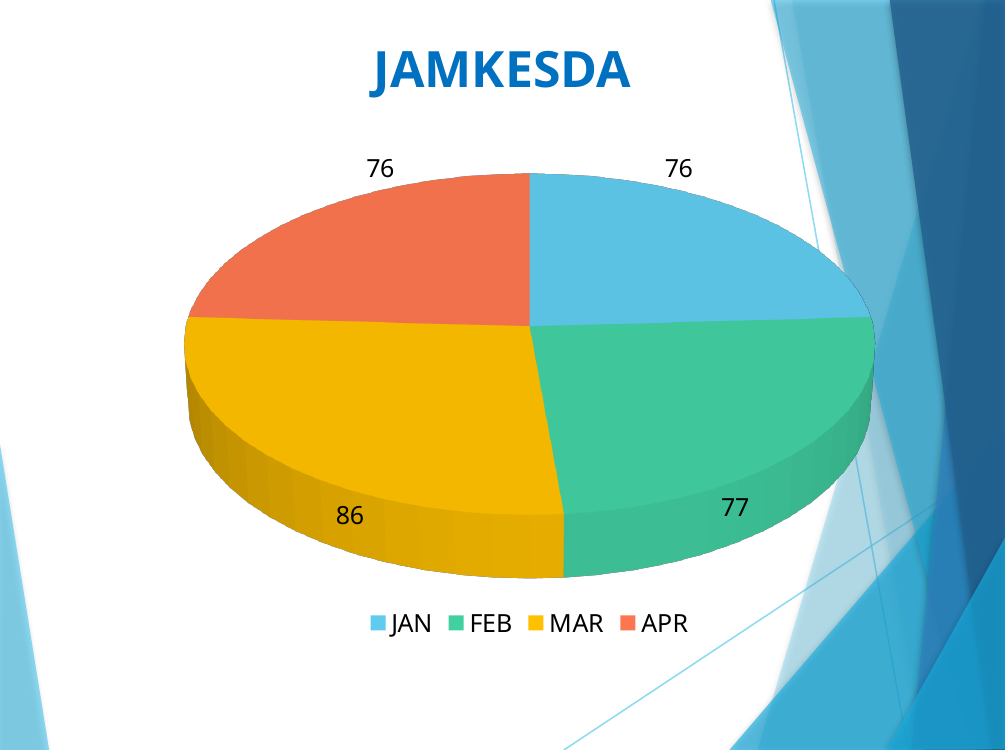
What type of chart is shown on the slide? pie chart How many slices does the pie chart have? 4 What is the value for MAR? 86 What is the difference between the values for MAR and FEB? 9 How many entries does the legend list? 4 What is the title of the chart? JAMKESDA What is the value for FEB? 77 What is the value for APR? 76 Which month has the largest slice of the pie? MAR What is the value for JAN? 76 What colour is the slice for MAR? yellow Which is larger, the value for MAR or the value for APR? MAR